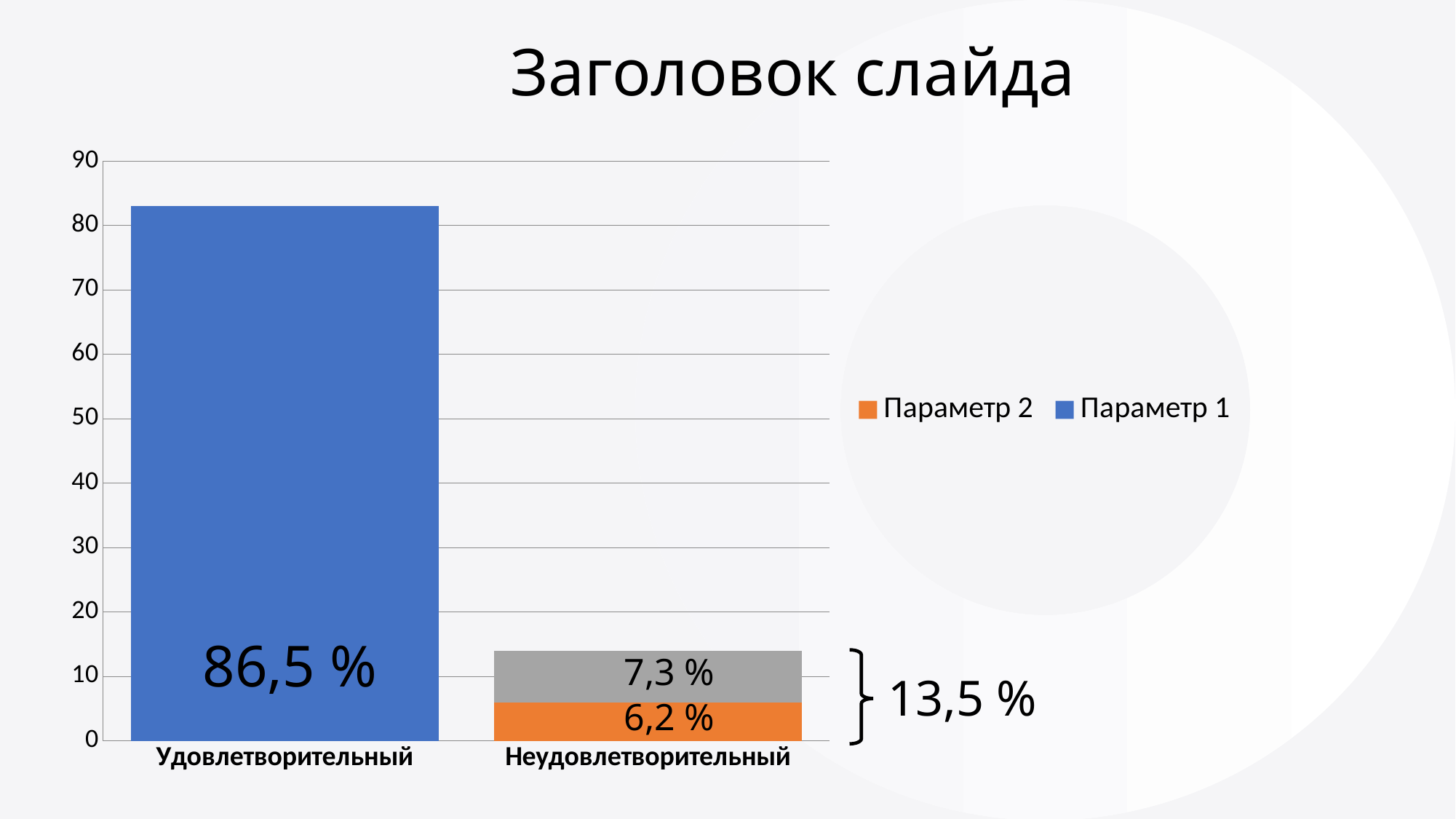
How many series does the legend list? 2 Which category has the lowest bar? Неудовлетворительный How many categories are shown on the x axis? 2 What is the title of the slide? Заголовок слайда What value is labelled on the grey segment of the Неудовлетворительный bar? 7,3 % What value is labelled on the bar for Удовлетворительный? 86,5 % Which category has the taller bar, Удовлетворительный or Неудовлетворительный? Удовлетворительный What total is shown by the bracket next to the Неудовлетворительный bar? 13,5 % What is the difference between the grey segment (7,3 %) and the orange segment (6,2 %) of the Неудовлетворительный bar? 1,1 % What value is labelled on the orange segment of the Неудовлетворительный bar? 6,2 % What kind of chart is shown on the slide? bar chart Is the top of the Неудовлетворительный bar greater or less than 20 on the axis? less